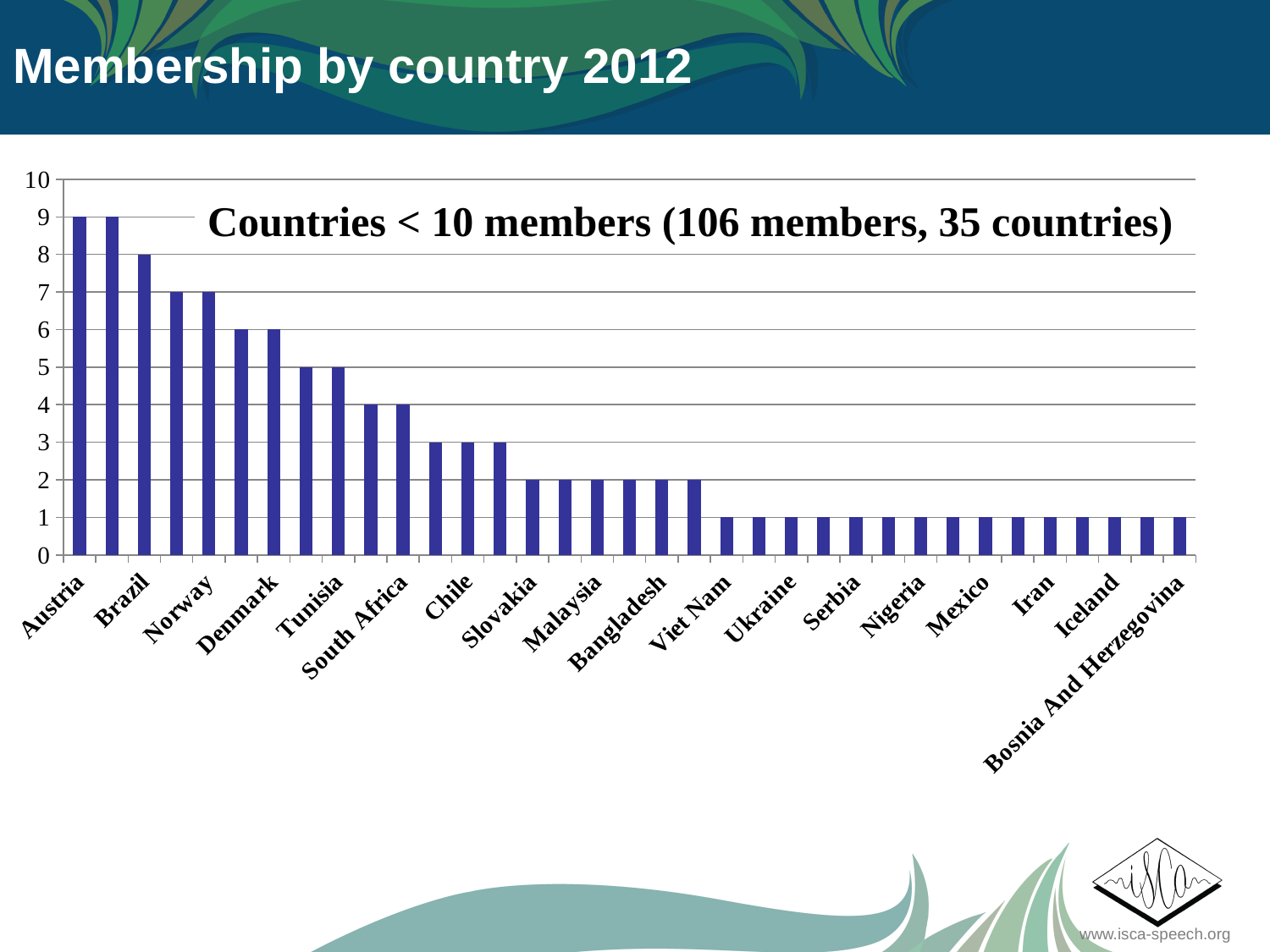
How many members does Viet Nam have? 1 Which has more members, South Africa or Slovakia? South Africa What is the difference in members between Austria and Denmark? 3 What is the title shown inside the chart area? Countries < 10 members (106 members, 35 countries) How many members does Austria have? 9 How many members does Brazil have? 8 How many countries are represented in the chart? 35 How many members does Chile have? 3 How many members does Tunisia have? 5 Do the bar values rise or fall from left to right along the x axis? fall How many members does Norway have? 7 What type of chart is shown on the slide? bar chart